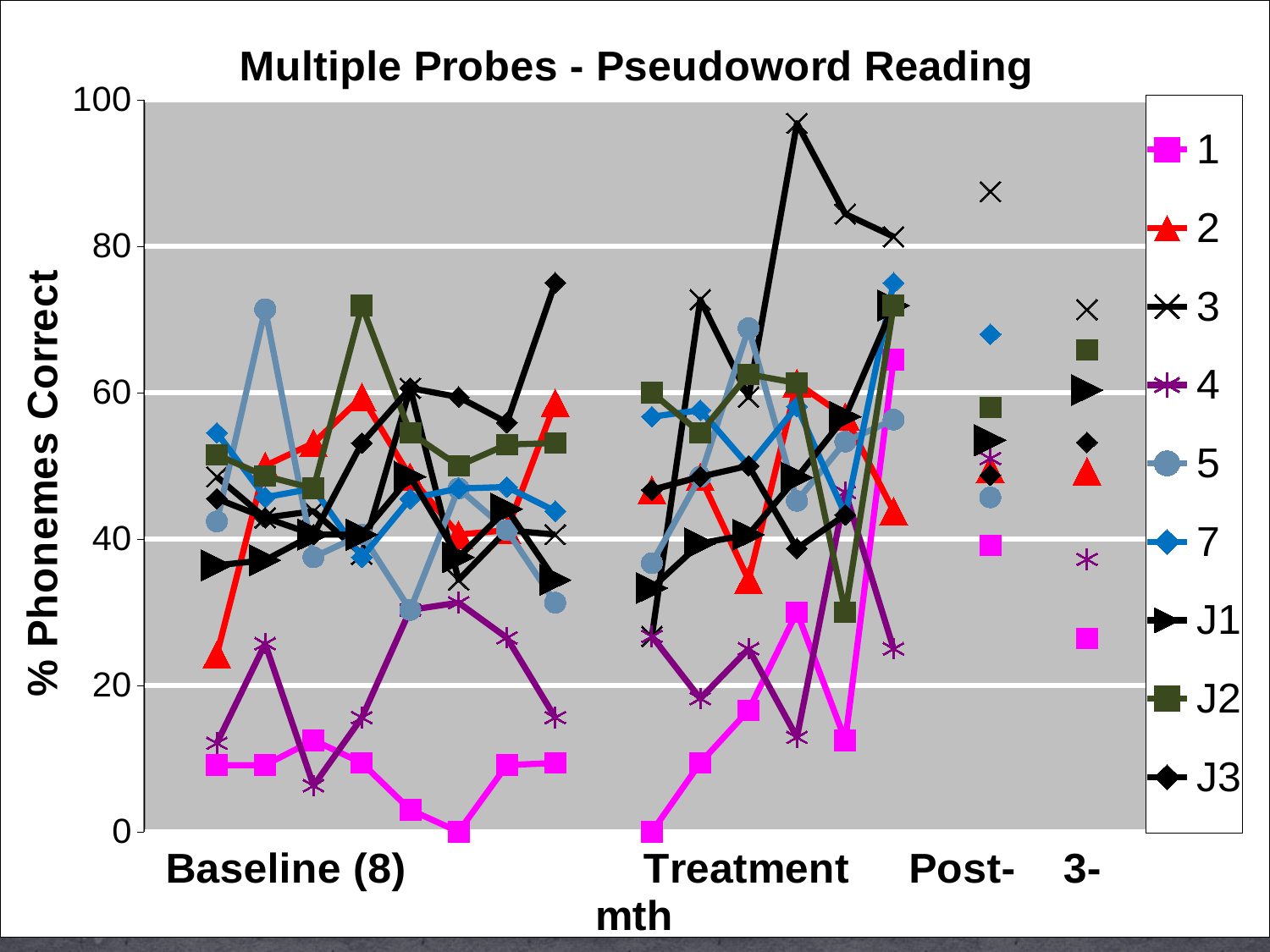
What is the title of the chart? Multiple Probes - Pseudoword Reading Is the value for series 1 at 3-mth greater or less than 20? greater What is the label on the vertical axis? % Phonemes Correct How many series does the legend list? 9 Which series has the lowest value at 3-mth? 1 Which series has the highest value at Post-? 3 Is the value for series 3 at Post- greater or less than 80? greater At 3-mth, which series has the larger value, 3 or 4? 3 Are the values for series 1 during the Baseline phase greater or less than 20? less How many probes are indicated for the Baseline phase in the x-axis label? 8 What kind of chart is shown on the slide? line chart